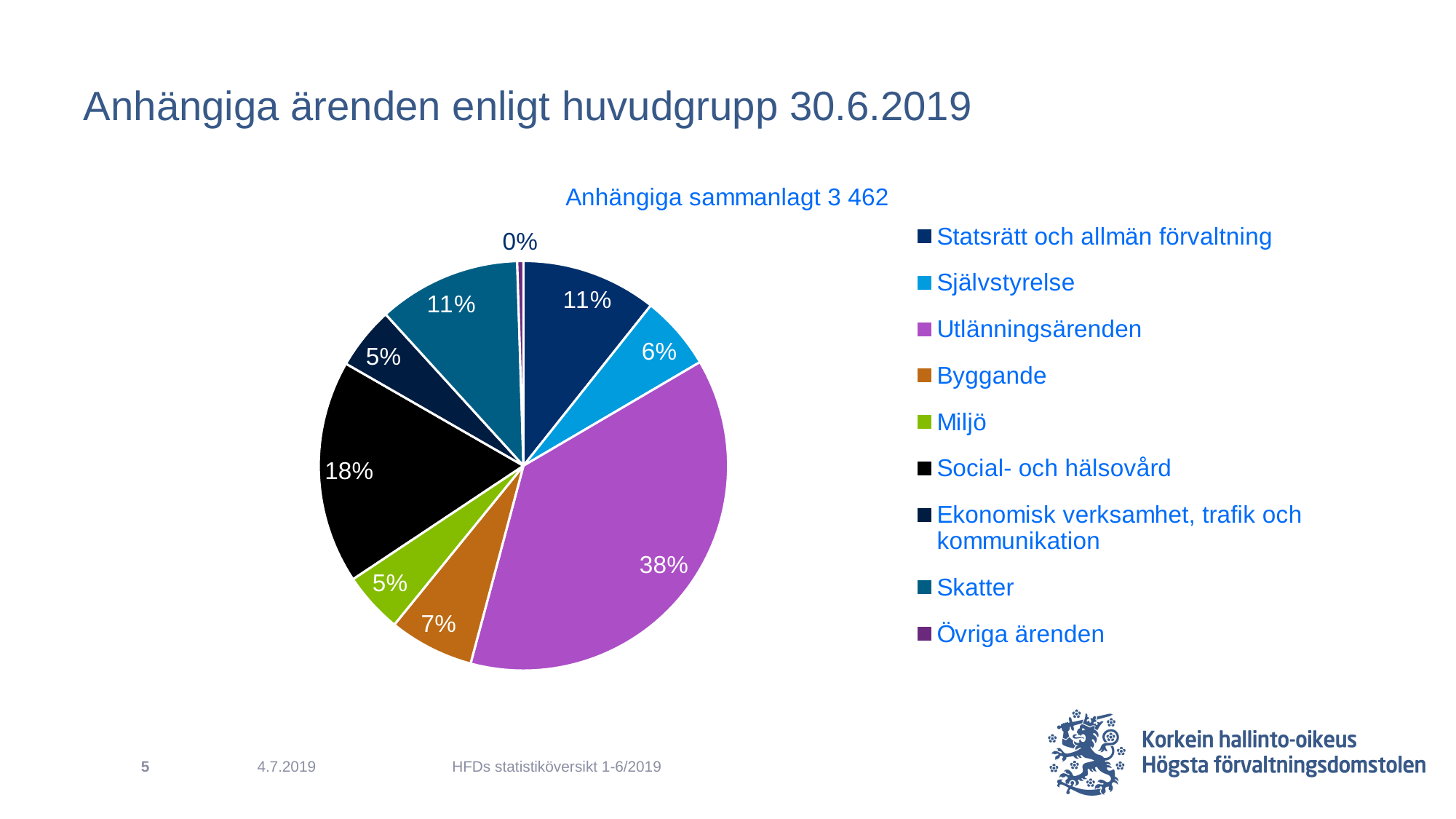
Which category has the largest slice of the pie? Utlänningsärenden What is the value shown for Självstyrelse? 6% What is the value shown for Skatter? 11% Which category has the smallest slice of the pie? Övriga ärenden What is the difference in percentage points between Utlänningsärenden and Social- och hälsovård? 20 What total number of pending cases is stated in the chart title? 3 462 What share of the pie does Utlänningsärenden have? 38% How many categories does the legend list? 9 What is the value shown for Byggande? 7% What kind of chart is shown on the slide? pie chart Which is larger, the slice for Byggande or the slice for Miljö? Byggande What share of the pie does Social- och hälsovård have? 18%